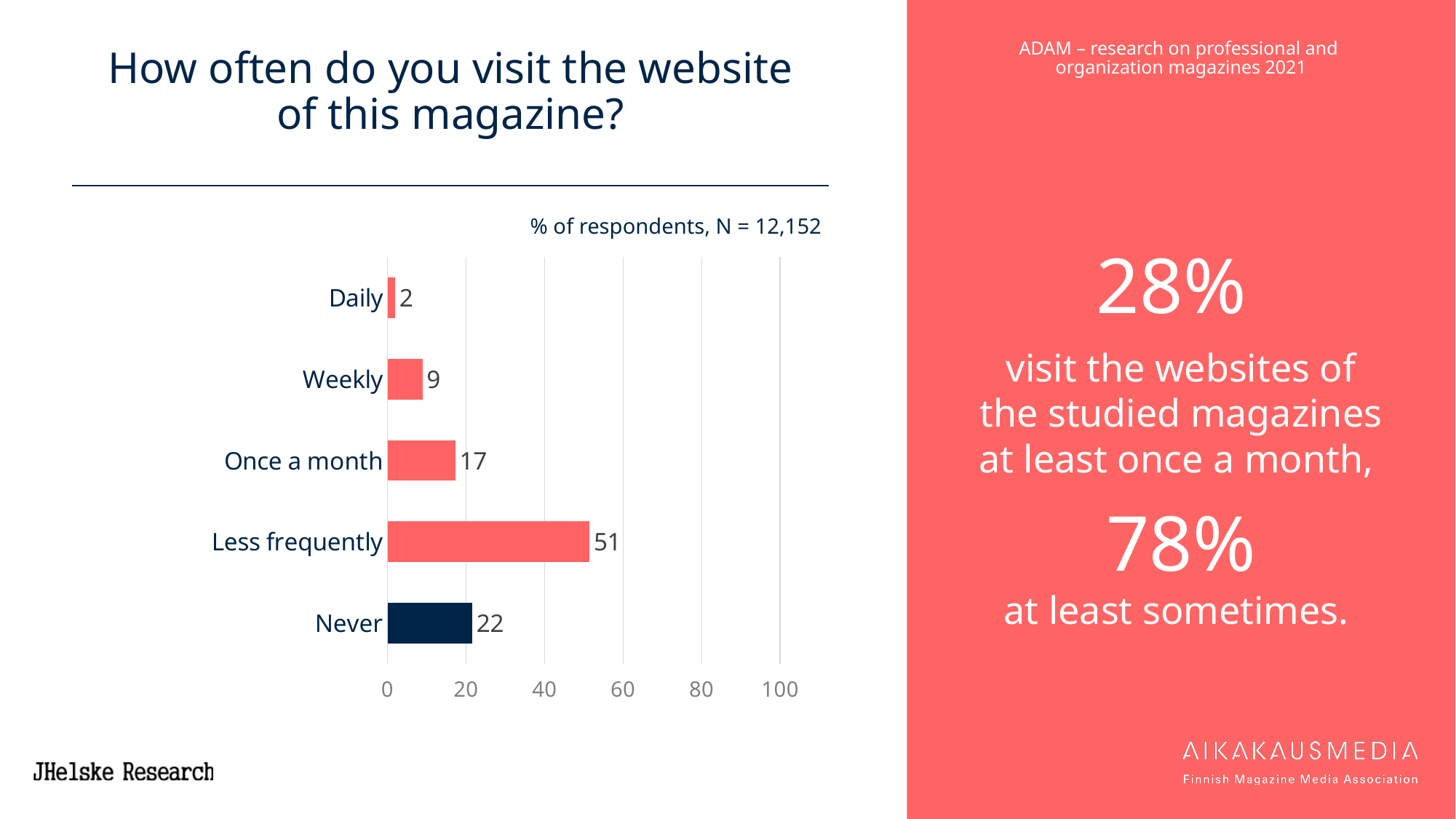
Is the value for 'Less frequently' greater or less than 40? greater What percentage of respondents visit the magazine's website daily? 2 What kind of chart is shown on the slide? bar chart Which bar is coloured dark navy instead of red? Never What value is shown for 'Never'? 22 Which category has the highest value? Less frequently What is the difference between the values for 'Less frequently' and 'Never'? 29 What value is shown for 'Less frequently'? 51 What is the sum of the values for 'Daily', 'Weekly' and 'Once a month'? 28 How many categories are shown in the chart? 5 Which category has the lowest value? Daily Which is larger, the value for 'Weekly' or the value for 'Once a month'? Once a month